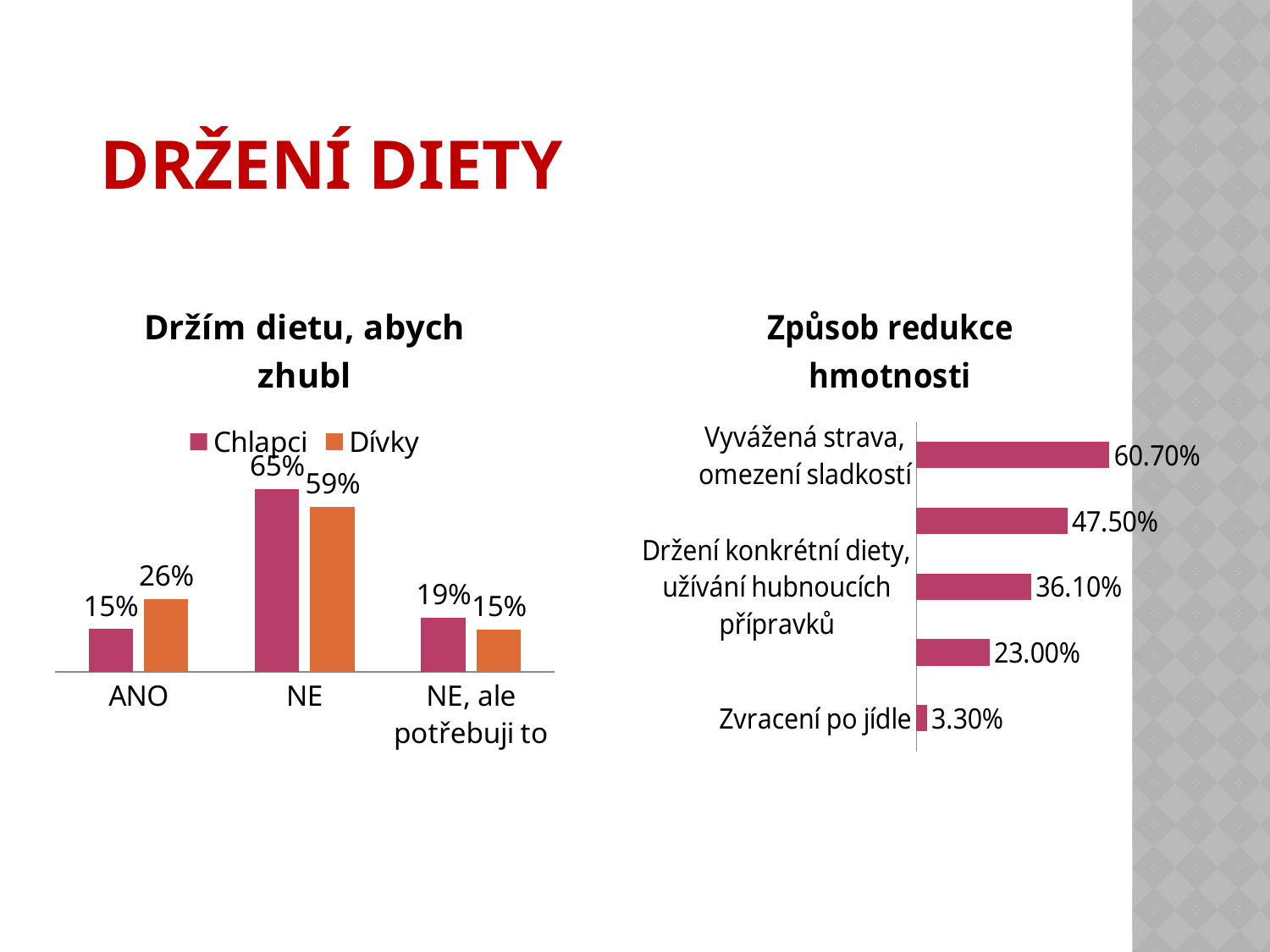
In the chart titled "Držím dietu, abych zhubl", which series has the larger value in the "NE, ale potřebuji to" category, Chlapci or Dívky? Chlapci In the chart titled "Držím dietu, abych zhubl", how many categories are shown on the x axis? 3 In the chart titled "Držím dietu, abych zhubl", which category has the highest value for Dívky? NE In the chart titled "Držím dietu, abych zhubl", how many series does the legend list? 2 In the chart titled "Držím dietu, abych zhubl", what is the value for Chlapci in the NE category? 65% In the chart titled "Způsob redukce hmotnosti", how many bars are plotted? 5 In the chart titled "Způsob redukce hmotnosti", what is the value for "Zvracení po jídle"? 3.30% In the chart titled "Držím dietu, abych zhubl", what is the difference between the Dívky and Chlapci values for ANO? 11% In the chart titled "Způsob redukce hmotnosti", which category has the lowest value? Zvracení po jídle In the chart titled "Držím dietu, abych zhubl", what is the value for Dívky in the ANO category? 26% What kind of chart is the chart titled "Způsob redukce hmotnosti"? Bar chart In the chart titled "Způsob redukce hmotnosti", what is the value for "Vyvážená strava, omezení sladkostí"? 60.70%